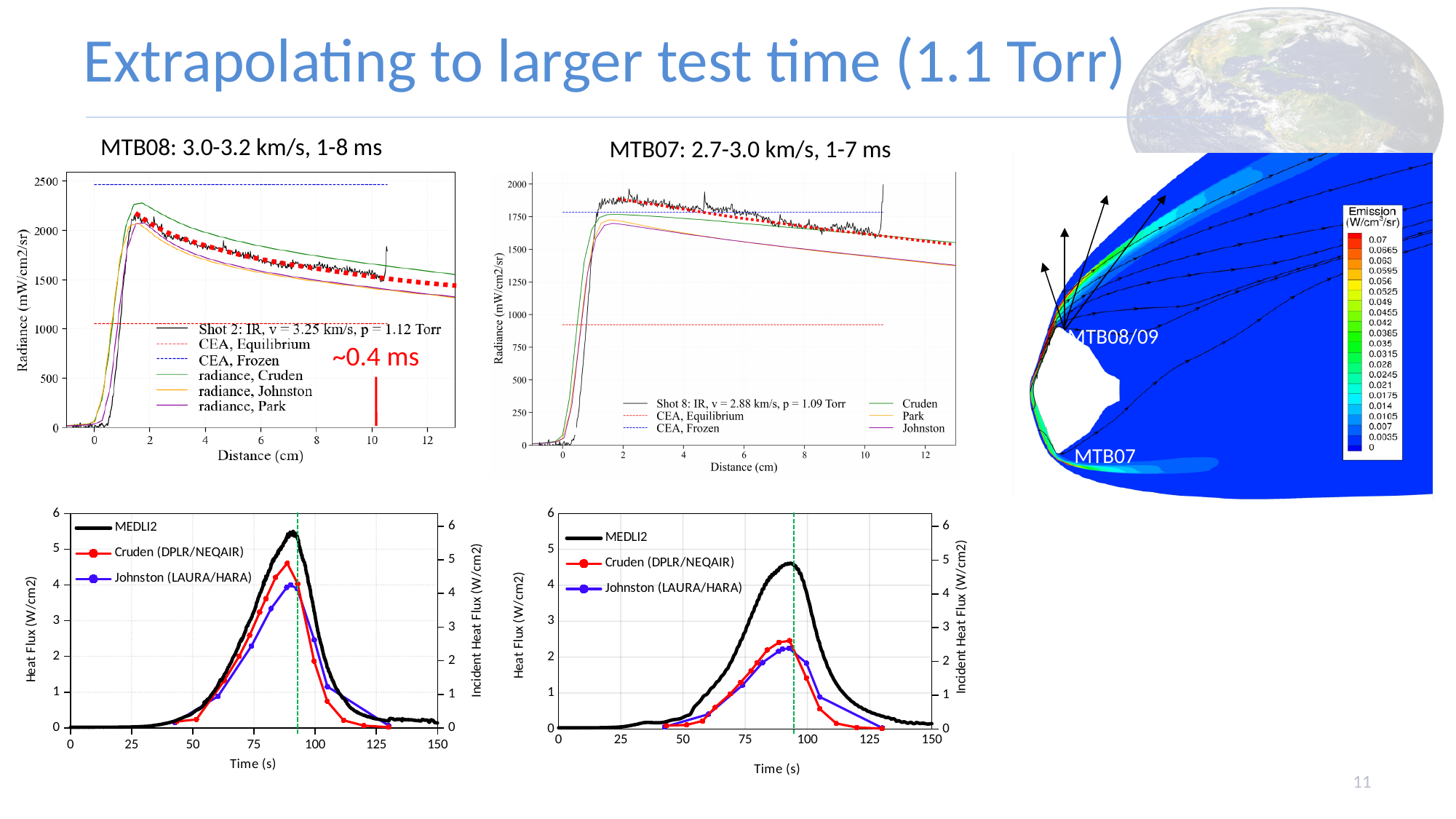
In the MTB08 radiance chart (top left), is the CEA, Equilibrium level greater or less than 1500 mW/cm2/sr? less How many series does the legend of the bottom-left heat flux chart list? 3 In the bottom-left heat flux chart, is the peak of the MEDLI2 curve greater or less than 5 W/cm2? greater In the bottom-left heat flux chart, which series reaches the highest peak heat flux? MEDLI2 In the MTB08 radiance chart (top left), is the CEA, Frozen level greater or less than 2000 mW/cm2/sr? greater What is the x-axis label of the bottom-left heat flux chart? Time (s) In the MTB08 radiance chart (top left), do the radiance curves rise or fall with distance after their peak near 2 cm? fall How many series does the legend of the MTB08 radiance chart (top left) list? 6 What kind of chart is the MTB08 radiance chart at the top left of the slide? line chart